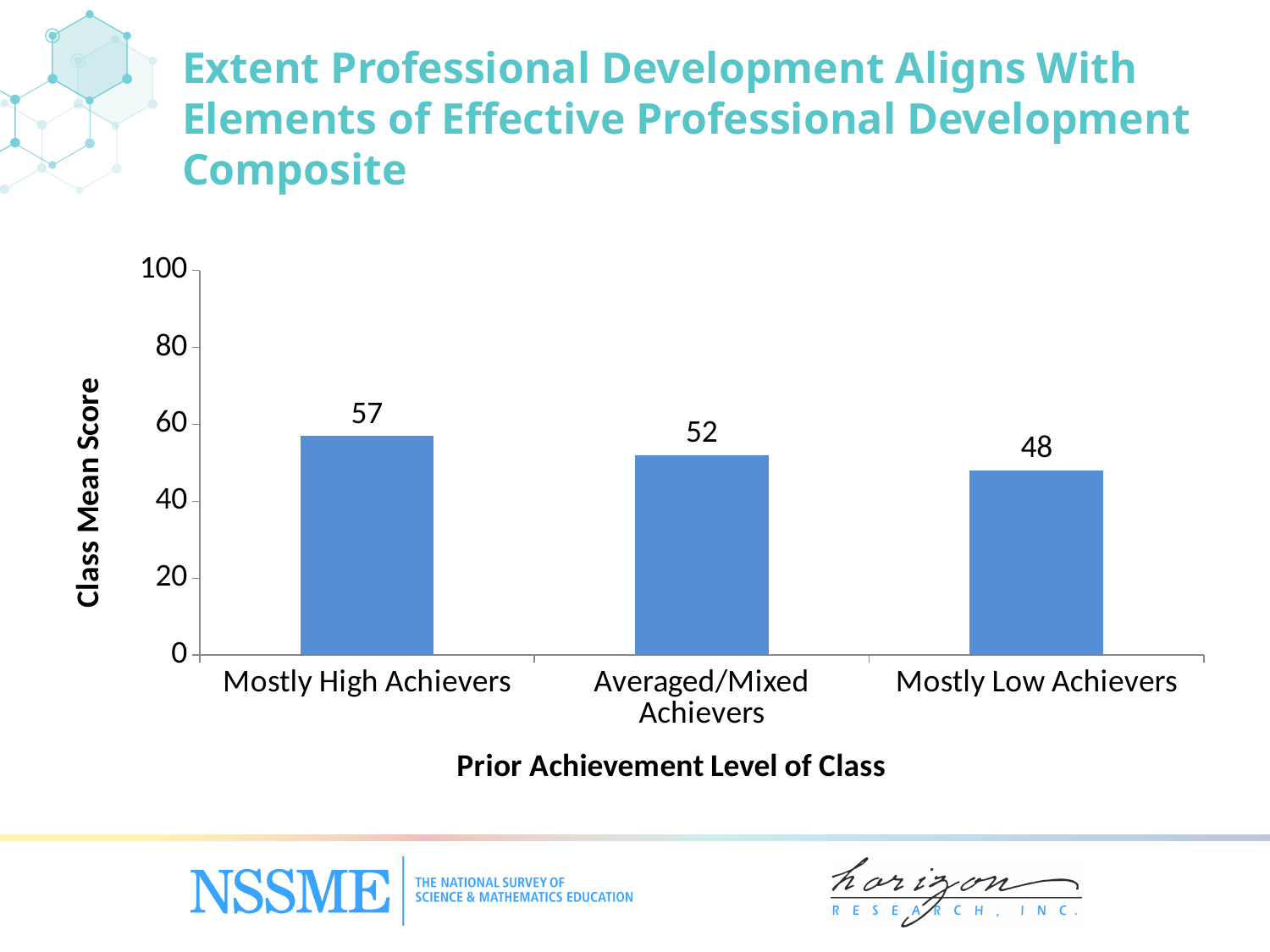
What is the difference between the class mean scores for Mostly High Achievers and Mostly Low Achievers? 9 Which prior achievement level has the lowest class mean score? Mostly Low Achievers What is the label of the y axis? Class Mean Score What is the class mean score for Mostly Low Achievers? 48 What is the difference between the class mean scores for Averaged/Mixed Achievers and Mostly Low Achievers? 4 Which has a higher class mean score, Mostly High Achievers or Averaged/Mixed Achievers? Mostly High Achievers How many prior achievement level categories are shown in the chart? 3 What is the class mean score for Averaged/Mixed Achievers? 52 What is the class mean score for Mostly High Achievers? 57 Is the class mean score for Mostly Low Achievers greater or less than 60? less What kind of chart is shown on the slide? bar chart Which prior achievement level has the highest class mean score? Mostly High Achievers